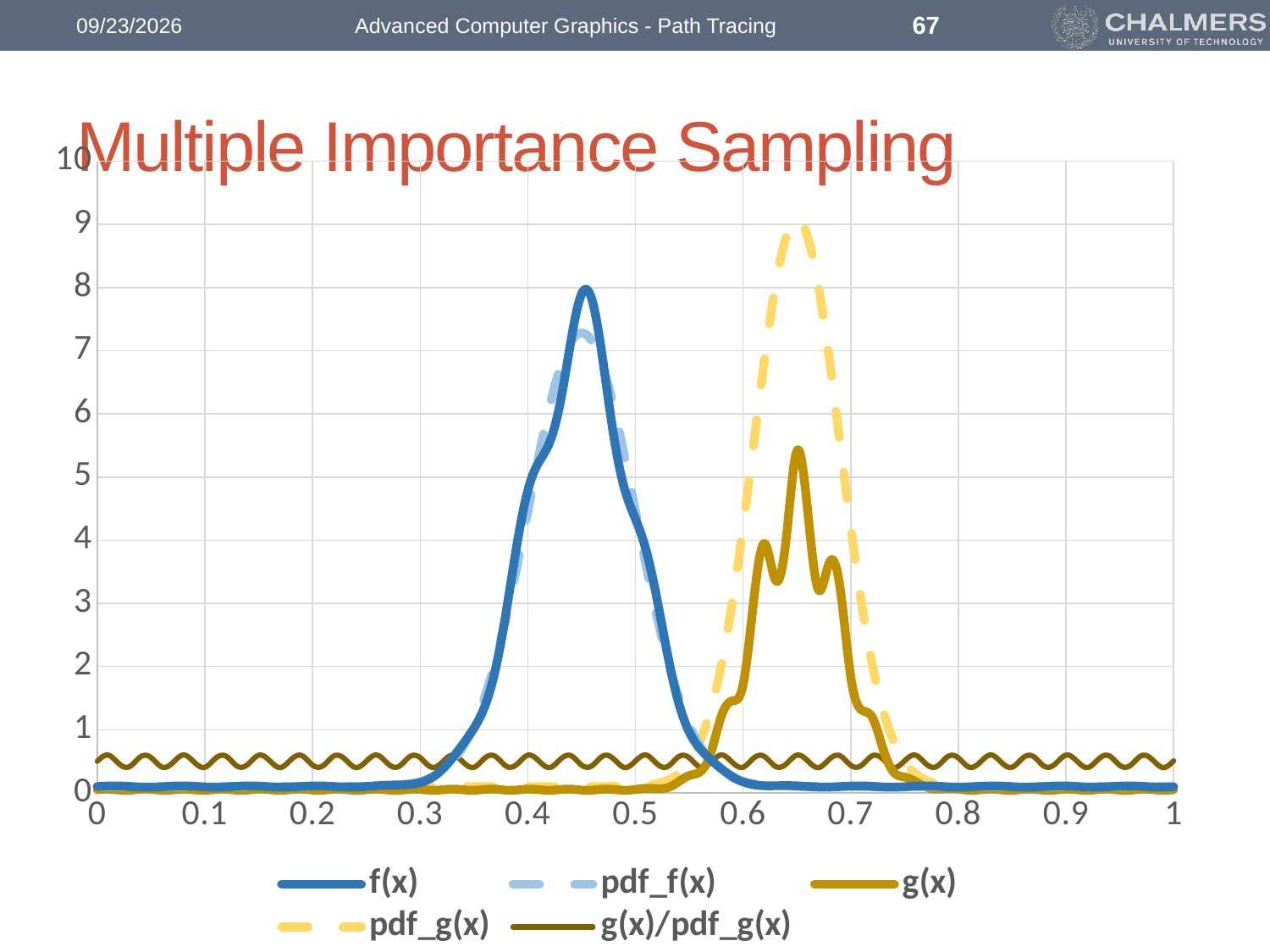
Is the peak value of f(x) greater or less than 9? less Is the peak value of g(x) greater or less than 6? less Which two series are drawn with dashed lines? pdf_f(x) and pdf_g(x) What is the title of the slide containing the chart? Multiple Importance Sampling Does g(x)/pdf_g(x) rise, fall, or stay roughly flat across the x axis? roughly flat Is the peak value of f(x) greater or less than 7? greater Which series reaches the highest peak value? pdf_g(x) Which series has the lowest maximum value? g(x)/pdf_g(x) What kind of chart is shown on the slide? line chart How many series does the legend list? 5 Which series has a higher peak, f(x) or g(x)? f(x)